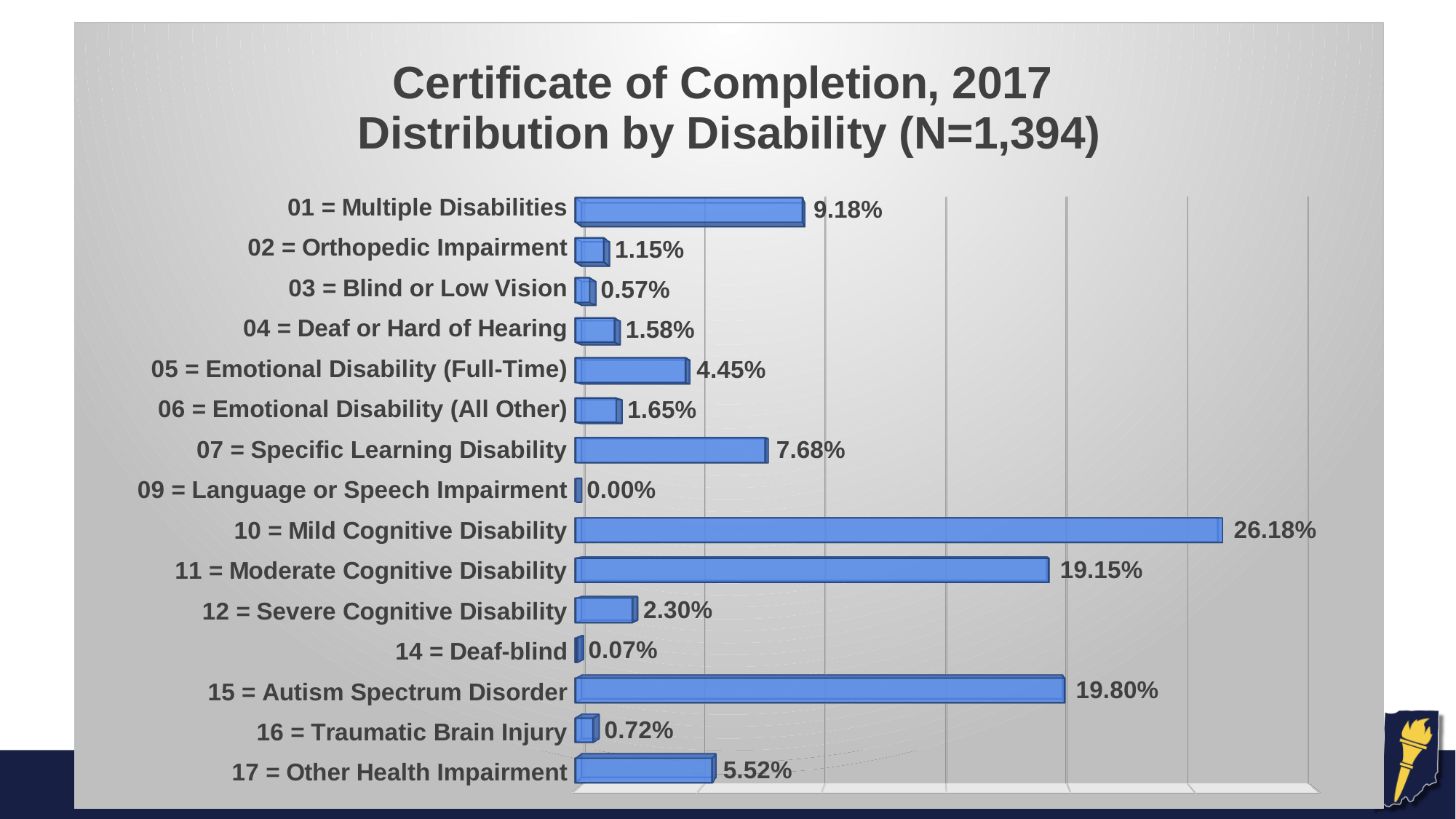
What is the value for 10 = Mild Cognitive Disability? 26.18% Which is larger, the value for 11 = Moderate Cognitive Disability or 15 = Autism Spectrum Disorder? 15 = Autism Spectrum Disorder Which category has the lowest value? 09 = Language or Speech Impairment Which category has the highest value? 10 = Mild Cognitive Disability What is the value for 14 = Deaf-blind? 0.07% What kind of chart is shown on the slide? Bar chart Which is larger, the value for 05 = Emotional Disability (Full-Time) or 17 = Other Health Impairment? 17 = Other Health Impairment What is the difference between the values for 10 = Mild Cognitive Disability and 15 = Autism Spectrum Disorder? 6.38% What is the value for 07 = Specific Learning Disability? 7.68% What is the difference between the values for 01 = Multiple Disabilities and 07 = Specific Learning Disability? 1.50% What is the value for 15 = Autism Spectrum Disorder? 19.80% How many disability categories are shown in the chart? 15